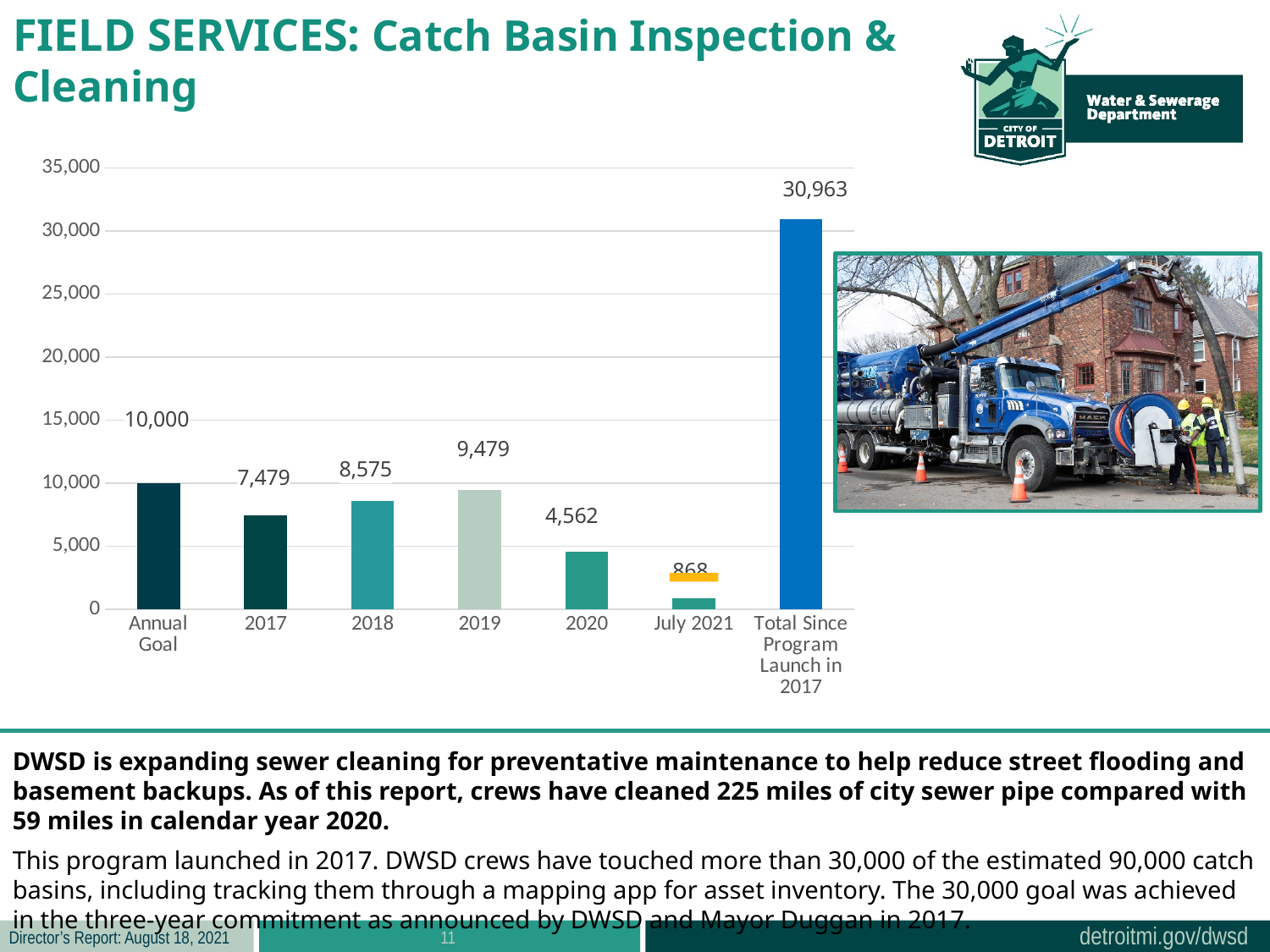
What is the value shown for Total Since Program Launch in 2017? 30,963 Which is larger, the value for 2019 or the value for 2018? 2019 What is the difference between the 2018 value and the 2017 value? 1,096 Which category has the lowest value in the chart? July 2021 What is the value of the Annual Goal bar? 10,000 How many categories are shown on the x axis of the chart? 7 Which category has the highest value in the chart? Total Since Program Launch in 2017 What is the value for 2020 in the catch basin chart? 4,562 What is the value for 2019 in the catch basin chart? 9,479 Do the values rise or fall from 2017 to 2019? rise What kind of chart is shown on the slide? bar chart Is the value for 2020 greater or less than 5,000? less